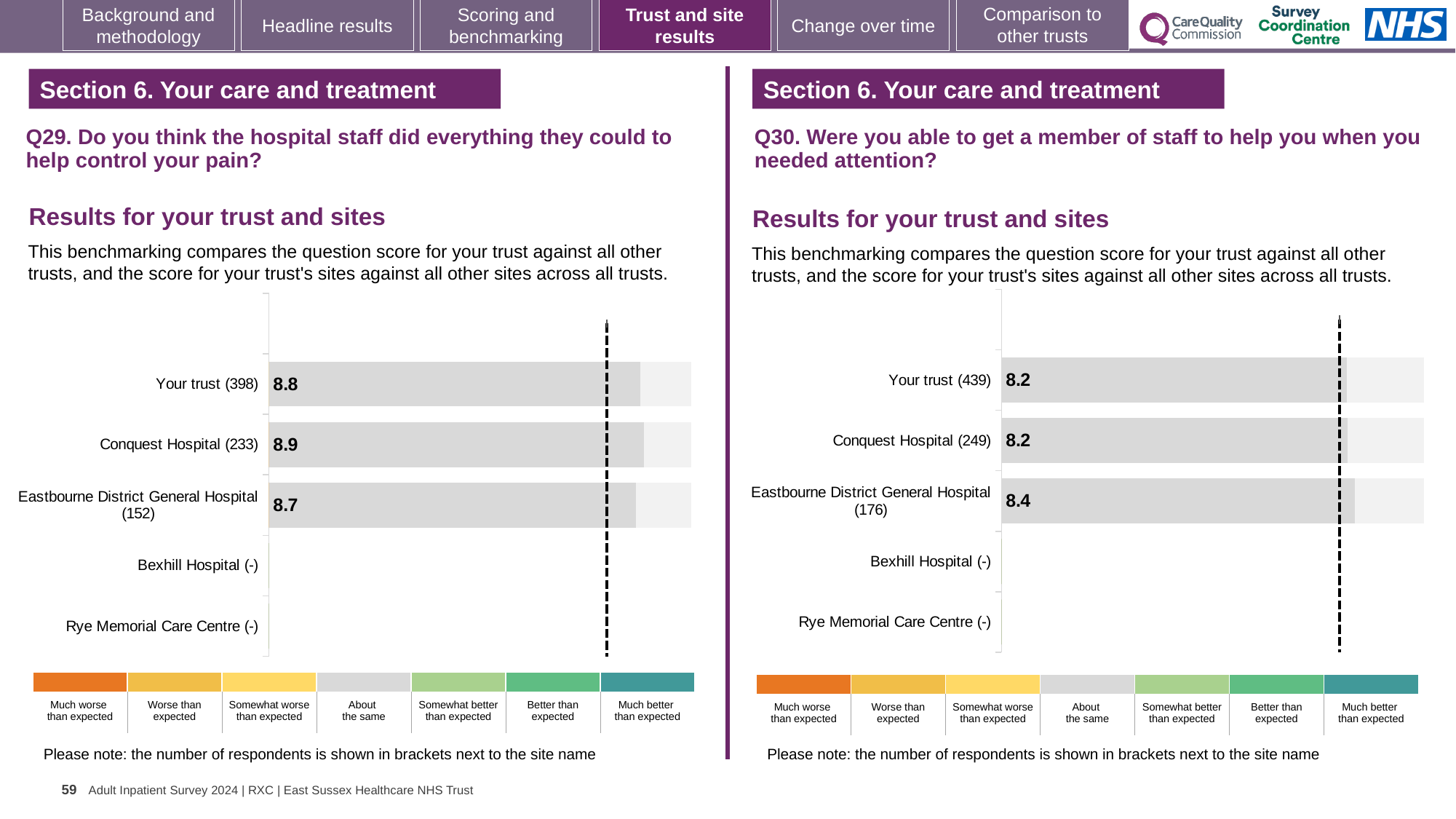
In the Q29 chart on the left, what is the score for Eastbourne District General Hospital (152)? 8.7 In the Q29 chart on the left, which site has the highest score? Conquest Hospital (233) In the Q30 chart on the right, what is the score for Your trust (439)? 8.2 In the Q30 chart on the right, how many respondents are shown in brackets for Conquest Hospital? 249 What kind of chart is used in the Q30 chart on the right? Bar chart In the Q29 chart on the left, what is the score for Your trust (398)? 8.8 In the Q30 chart on the right, what is the score for Eastbourne District General Hospital (176)? 8.4 In the Q29 chart on the left, how many site rows are listed on the vertical axis? 5 In the Q30 chart on the right, which site has the highest score? Eastbourne District General Hospital (176) In the Q29 chart on the left, what is the score for Conquest Hospital (233)? 8.9 In the Q30 chart on the right, what is the difference between the scores for Eastbourne District General Hospital and Conquest Hospital? 0.2 In the Q29 chart on the left, what is the difference between the scores for Conquest Hospital and Eastbourne District General Hospital? 0.2